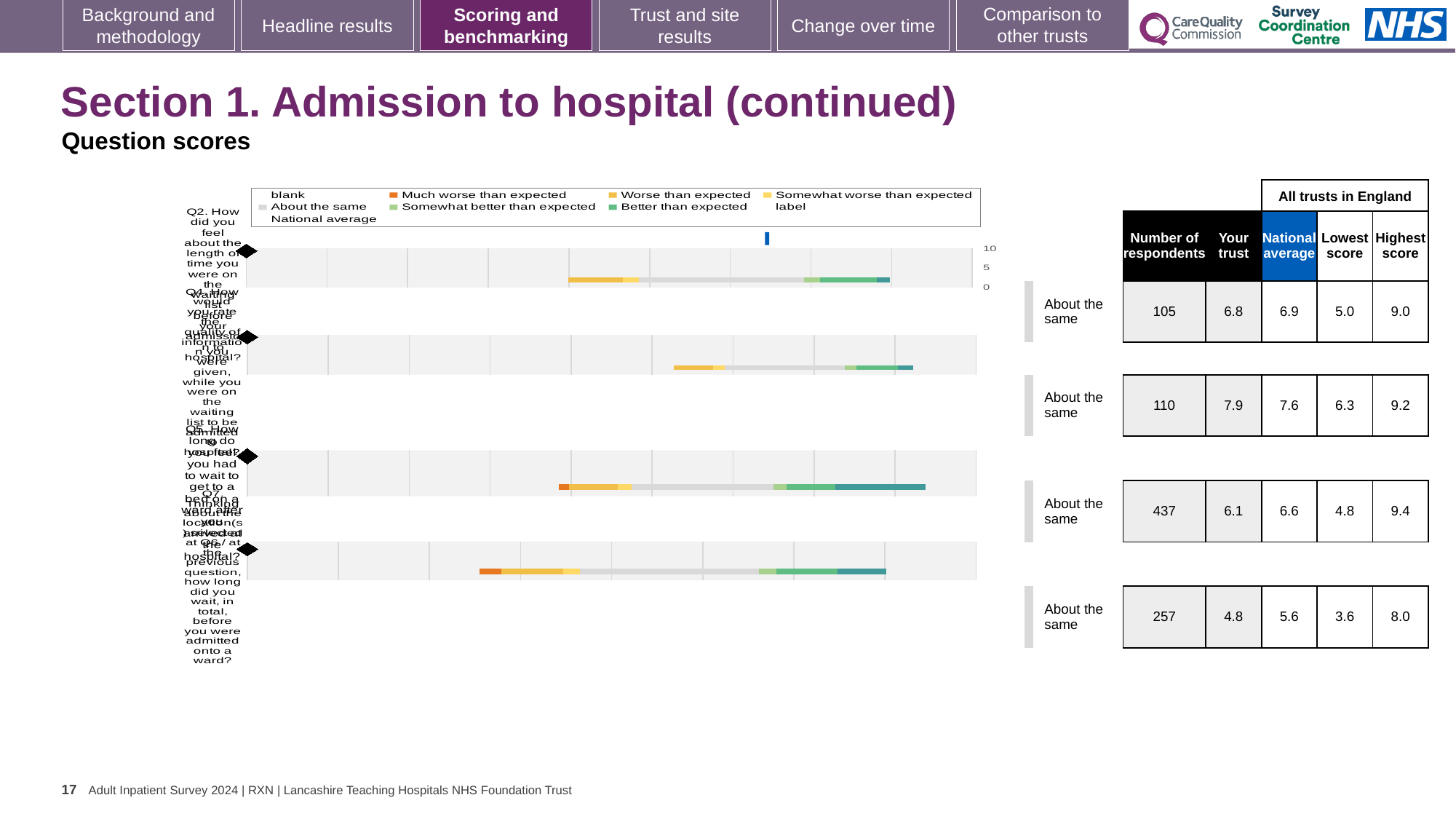
What is the highest score across all trusts in England for the fourth question row (Q7)? 8.0 For the second question row (Q4), is the 'Your trust' score or the national average larger? Your trust (7.9) What is the difference between the national average and the 'Your trust' score for the fourth question row (Q7)? 0.8 What is the national average for the second question row (Q4)? 7.6 What benchmark category is shown for every question row on this slide? About the same How many respondents are listed for the third question row (Q5)? 437 What is the lowest score across all trusts in England for the third question row (Q5)? 4.8 Which question row has the highest 'Your trust' score? Q4 (second row), 7.9 How many question rows (bars) are shown in the chart? 4 What kind of chart is used to show the question scores on this slide? bar chart What is the 'Your trust' score for the first question row (Q2)? 6.8 Which question row has the lowest 'Your trust' score? Q7 (fourth row), 4.8